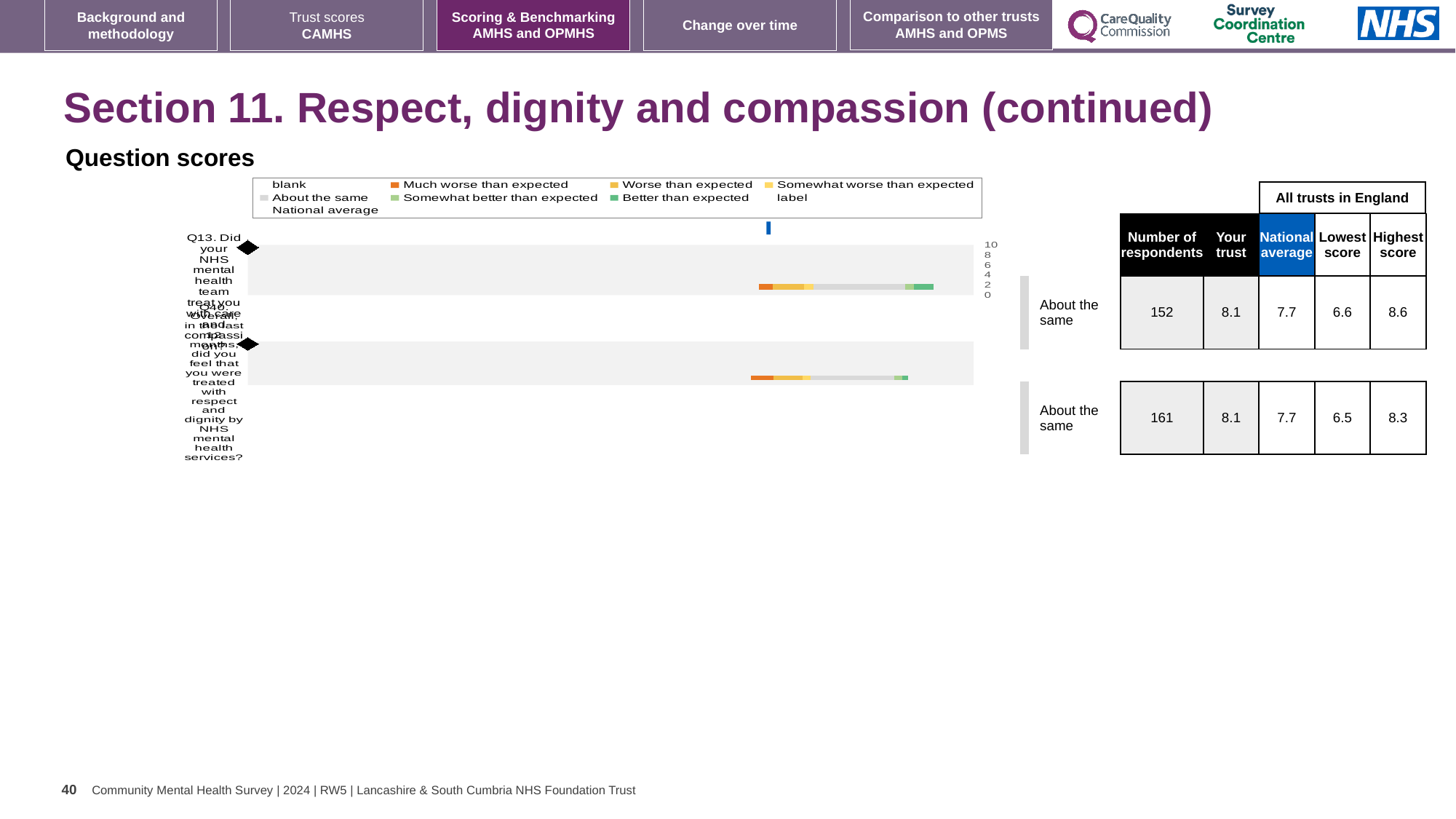
What is the lowest score across all trusts in England for Q16? 6.5 How many entries does the legend of the Question scores chart list? 9 What is the highest score across all trusts in England for Q13? 8.6 Which question has more respondents, Q13 or Q16? Q16 How many questions are plotted in the Question scores chart? 2 What benchmark category is shown for Q13 in the Question scores chart? About the same What kind of chart is shown under 'Question scores'? bar chart What is the national average for Q13 in the Question scores chart? 7.7 How many respondents are shown for Q16 in the Question scores chart? 161 By how much does the 'Your trust' score for Q16 exceed the national average? 0.4 What is the 'Your trust' score for Q13 in the Question scores chart? 8.1 What is the difference between the highest and lowest score for Q13? 2.0